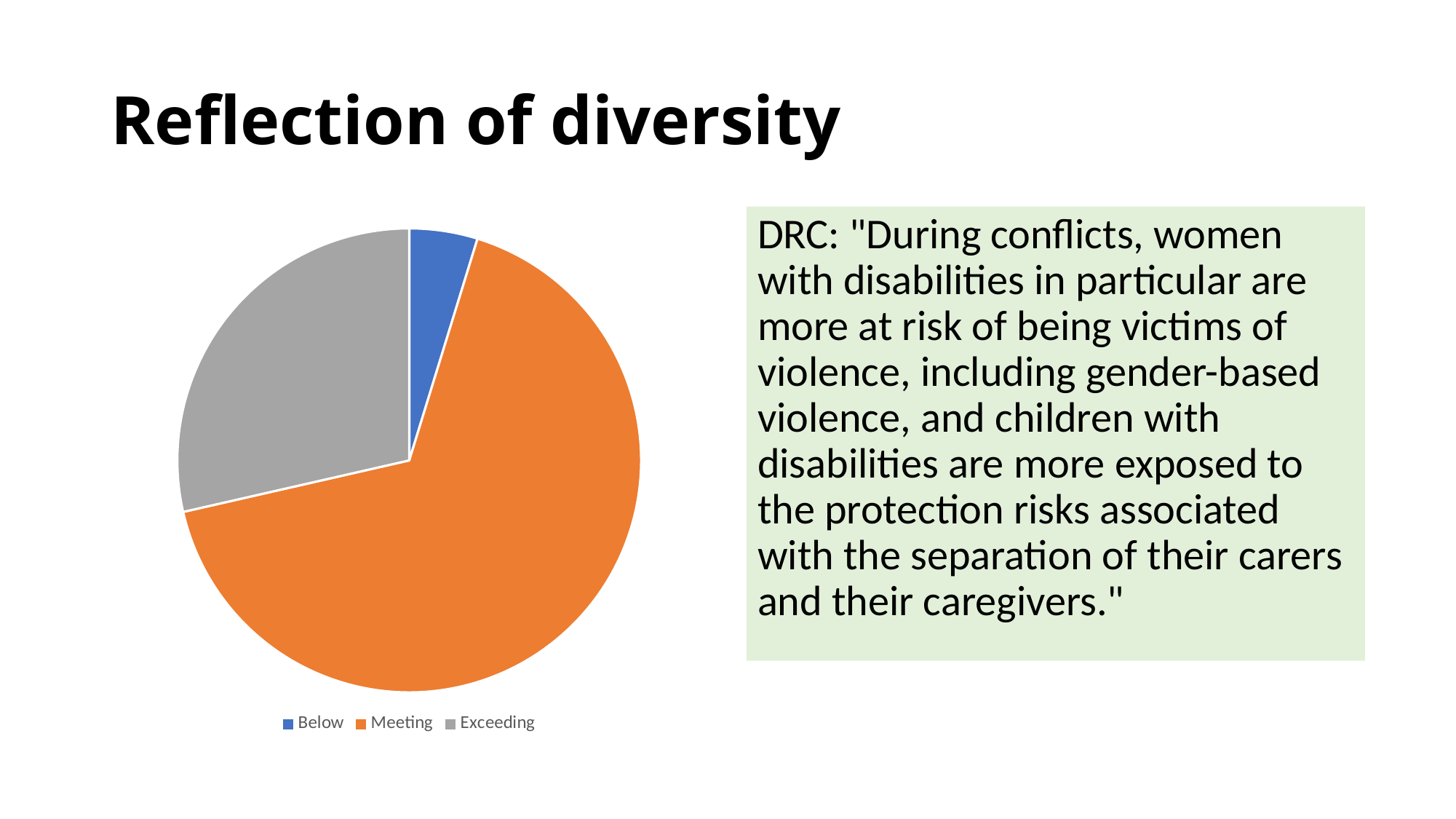
Which category is shown in grey in the pie chart? Exceeding What colour is the Meeting slice in the pie chart? orange Which slice is larger in the pie chart, Exceeding or Below? Exceeding Which category has the smallest slice in the pie chart? Below Which slice is larger in the pie chart, Meeting or Exceeding? Meeting What kind of chart is shown on the slide? pie chart How many entries does the legend of the pie chart list? 3 How many slices does the pie chart have? 3 Which category has the largest slice in the pie chart? Meeting